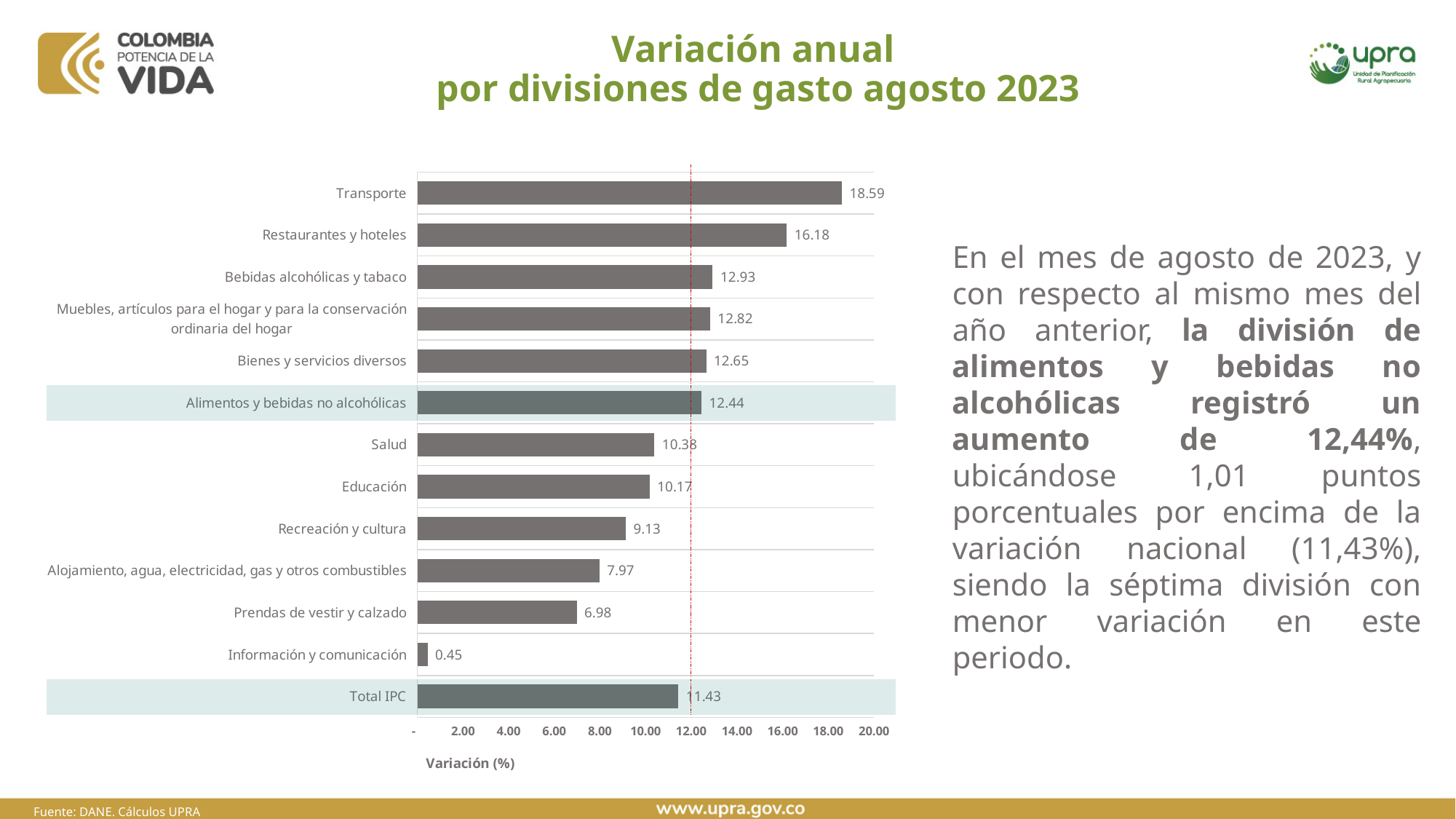
Which division has the lowest annual variation? Información y comunicación What is the annual variation for Transporte? 18.59 Is the value for Recreación y cultura greater or less than 10.00? less What is the difference between the values for Transporte and Restaurantes y hoteles? 2.41 Which is larger, the value for Salud or the value for Educación? Salud Which division has the highest annual variation? Transporte By how much does Alimentos y bebidas no alcohólicas exceed Total IPC? 1.01 What kind of chart is shown on the slide? Bar chart What value is shown for Alimentos y bebidas no alcohólicas? 12.44 What is the value of the Total IPC bar? 11.43 What is the value shown for Prendas de vestir y calzado? 6.98 How many bars are plotted in the chart, including Total IPC? 13